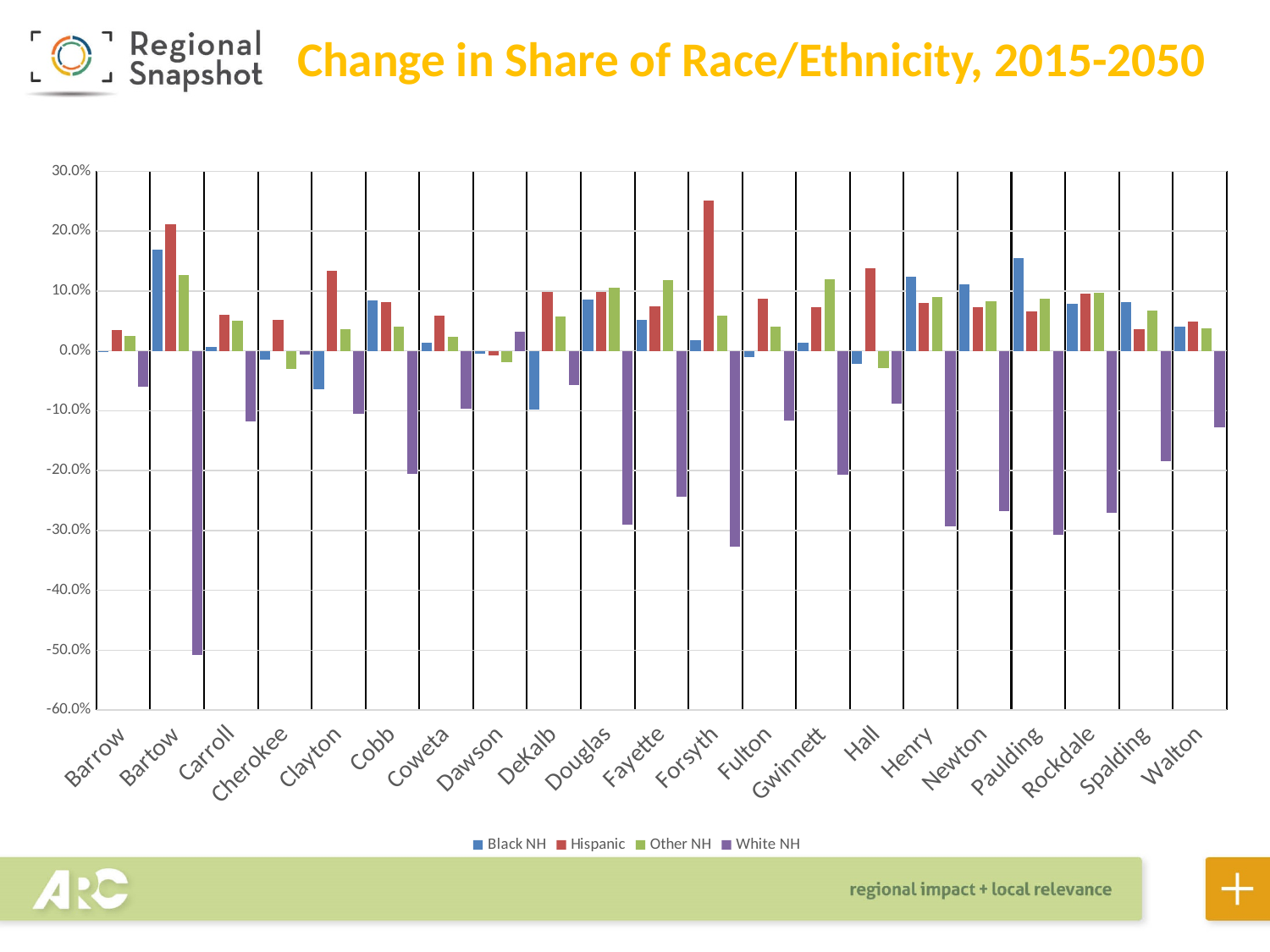
How many counties are shown on the x axis of the chart? 21 Which county has the highest Hispanic value? Forsyth Which is larger, the Black NH value for Bartow or the Black NH value for Fulton? Bartow What is the title of the chart? Change in Share of Race/Ethnicity, 2015-2050 Is the Hispanic value for Forsyth greater or less than 20.0%? greater Which county has the lowest White NH value? Bartow Is the White NH value for Newton greater or less than -20.0%? less Is the Hispanic value for Hall greater or less than 10.0%? greater Which is larger, the Hispanic value for Forsyth or the Hispanic value for Bartow? Forsyth What type of chart is shown on the slide? bar chart How many series does the legend list? 4